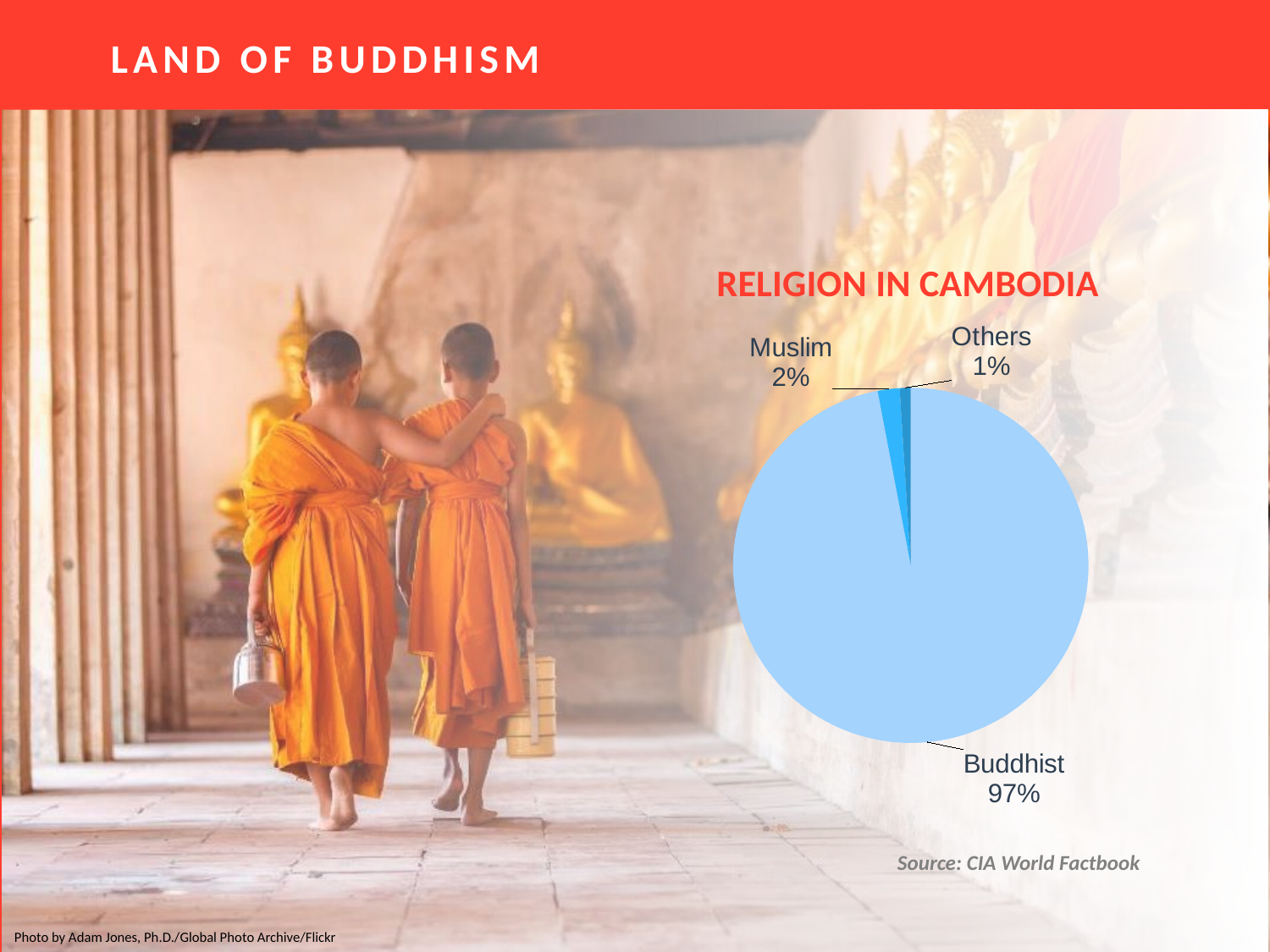
What is the difference between the Buddhist share and the Muslim share? 95% How many slices does the pie chart have? 3 What is the combined share of Muslim and Others? 3% What kind of chart is shown on the slide? pie chart What is the title of the chart? RELIGION IN CAMBODIA What source is cited for the chart data? CIA World Factbook What share of the pie is Muslim? 2% What share of the pie is Buddhist? 97% Which is larger, the Muslim share or the Others share? Muslim What share of the pie is Others? 1% Which category has the smallest slice of the pie? Others Which religion has the largest slice of the pie? Buddhist